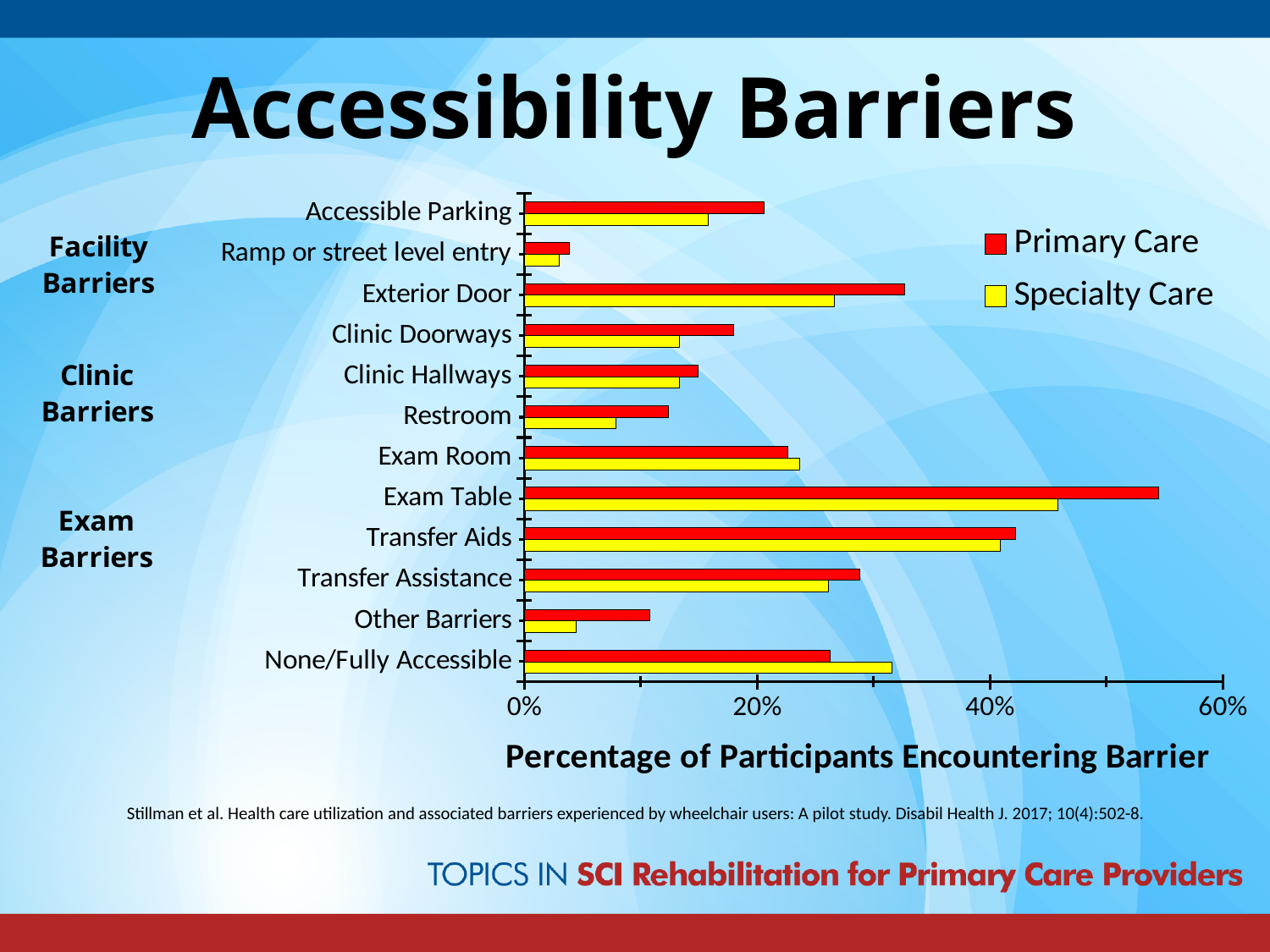
Is the Specialty Care value for None/Fully Accessible greater or less than 20%? greater Which barrier has the highest Primary Care percentage? Exam Table What kind of chart is shown on the slide? Bar chart How many barrier categories are plotted on the chart? 12 Is the Primary Care value for Exam Table greater or less than 40%? greater What colour represents Specialty Care in the legend? Yellow For Accessible Parking, which series has the larger value, Primary Care or Specialty Care? Primary Care Is the Primary Care value for Restroom greater or less than 20%? less For None/Fully Accessible, which series has the larger value, Primary Care or Specialty Care? Specialty Care Which barrier has the highest Specialty Care percentage? Exam Table Which barrier has the lowest Primary Care percentage? Ramp or street level entry How many series does the legend list? 2